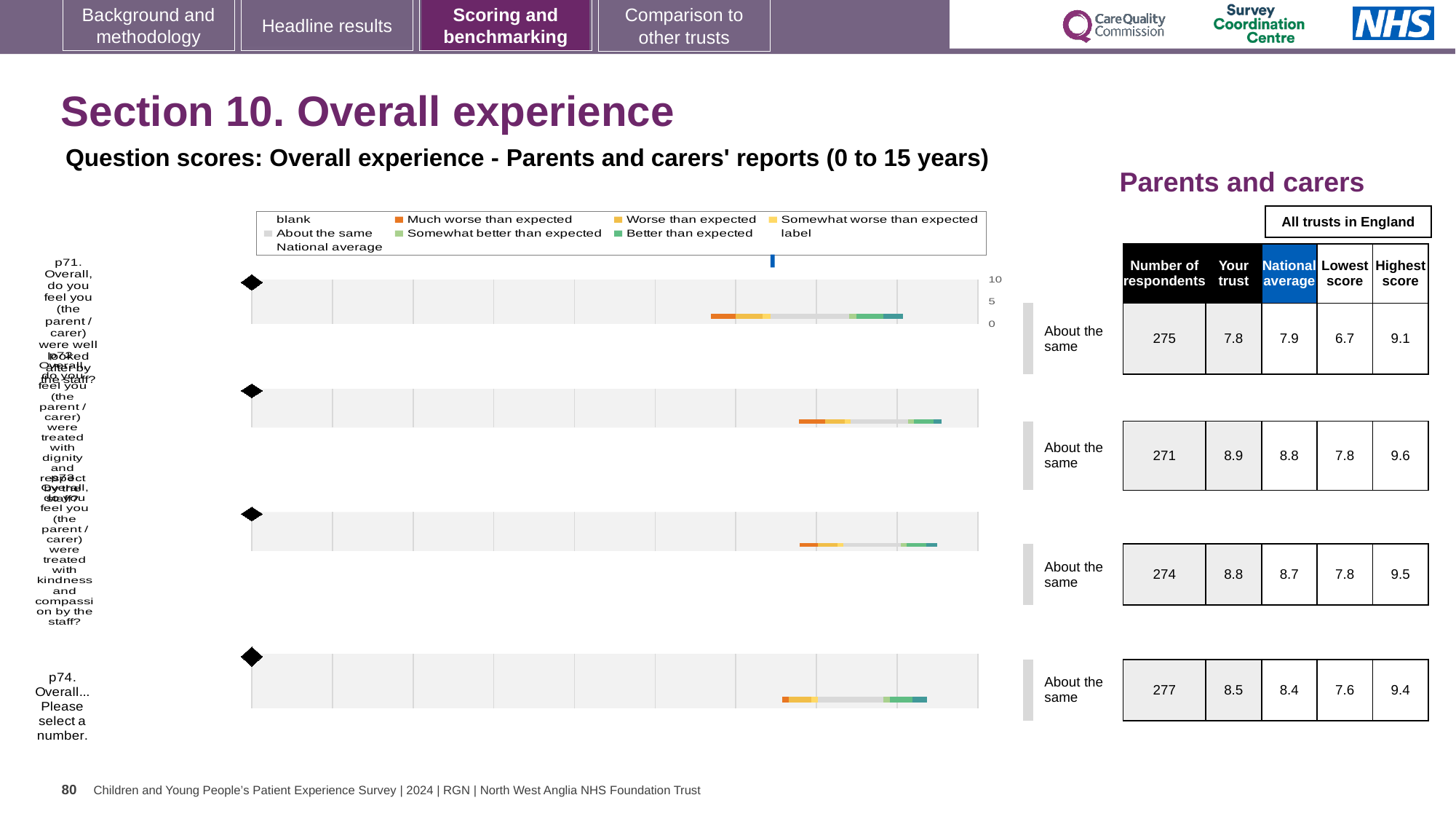
What is the highest value shown on the chart's numeric axis? 10 Which question has the highest 'Your trust' score in the table beside the chart? p72 What benchmark category is shown for each of the four questions on the slide? About the same How many questions (bars) are plotted in the chart? 4 Which legend entry is shown in orange? Much worse than expected In the table beside the chart, what is the national average for p74? 8.4 For p71, which is larger in the table beside the chart: the 'Your trust' score or the national average? National average In the table beside the chart, what is the 'Your trust' score for p71 (Overall, do you feel you were well looked after by the staff)? 7.8 Which question has the lowest 'Your trust' score in the table beside the chart? p71 What kind of chart is used to show the question scores on this slide? bar chart In the table beside the chart, what is the number of respondents for p74 (Overall... Please select a number)? 277 What is the difference between the 'Your trust' score and the national average for p72 in the table beside the chart? 0.1